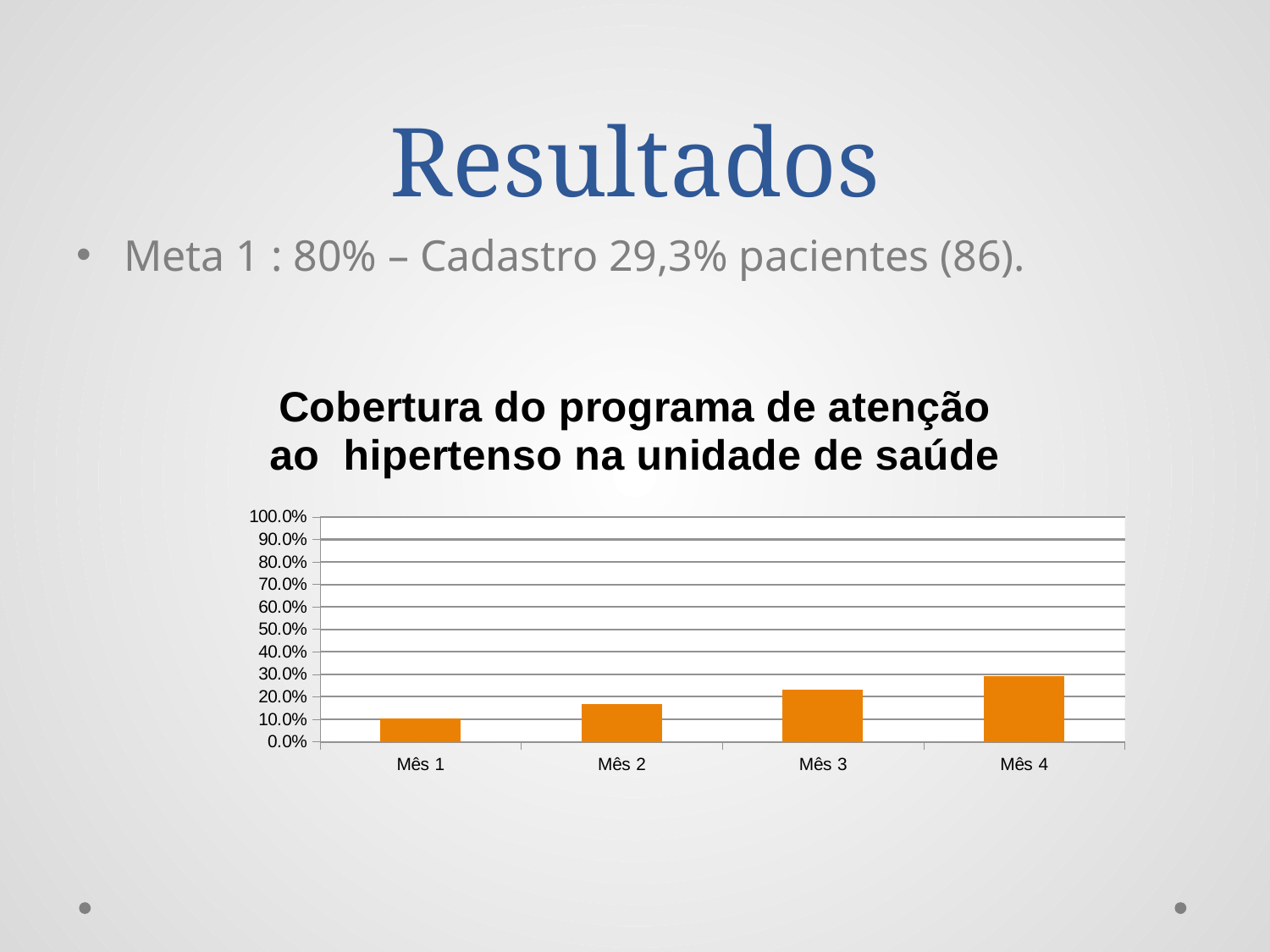
What kind of chart is shown on the slide? bar chart Which month has the highest coverage value in the chart? Mês 4 Is the value for Mês 3 greater or less than 20.0%? greater Is the value for Mês 3 greater or less than 30.0%? less Is the value for Mês 4 greater or less than 40.0%? less Which month has the lowest coverage value in the chart? Mês 1 Which is larger, the value for Mês 3 or the value for Mês 1? Mês 3 How many months (categories) are plotted on the x axis of the chart? 4 Do the values rise or fall from Mês 1 to Mês 4? rise What is the title of the chart? Cobertura do programa de atenção ao hipertenso na unidade de saúde